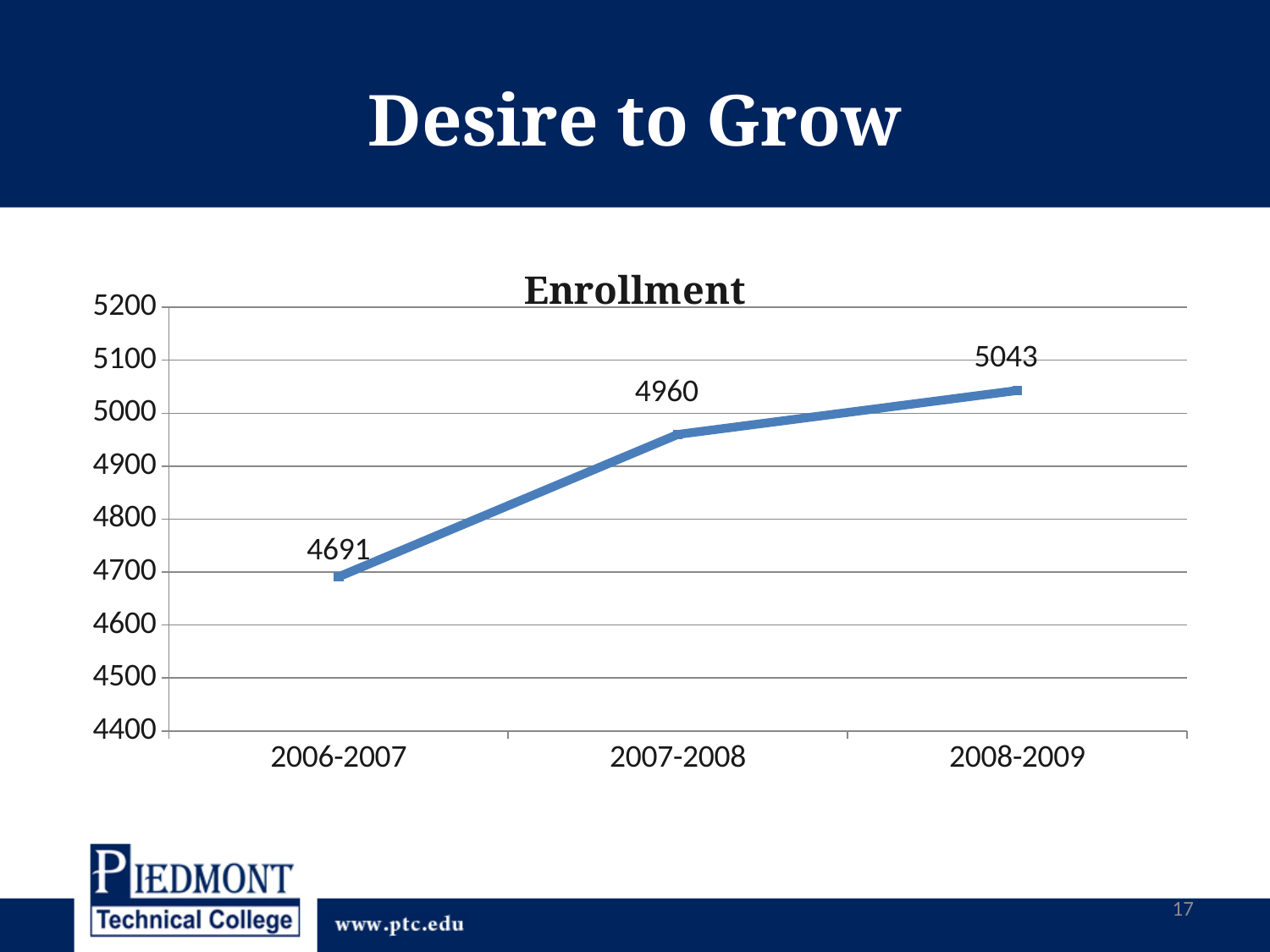
What is the difference in enrollment between 2008-2009 and 2007-2008? 83 Does enrollment rise or fall from 2006-2007 to 2008-2009? rise What is the enrollment value for 2007-2008? 4960 What is the difference in enrollment between 2007-2008 and 2006-2007? 269 Which academic year has the highest enrollment? 2008-2009 What kind of chart is shown on the slide? line chart Is the enrollment for 2007-2008 greater or less than 5000? less How many academic years are plotted on the chart? 3 What is the enrollment value for 2006-2007? 4691 What is the enrollment value for 2008-2009? 5043 Which academic year has the lowest enrollment? 2006-2007 Which is larger, the enrollment for 2006-2007 or for 2008-2009? 2008-2009